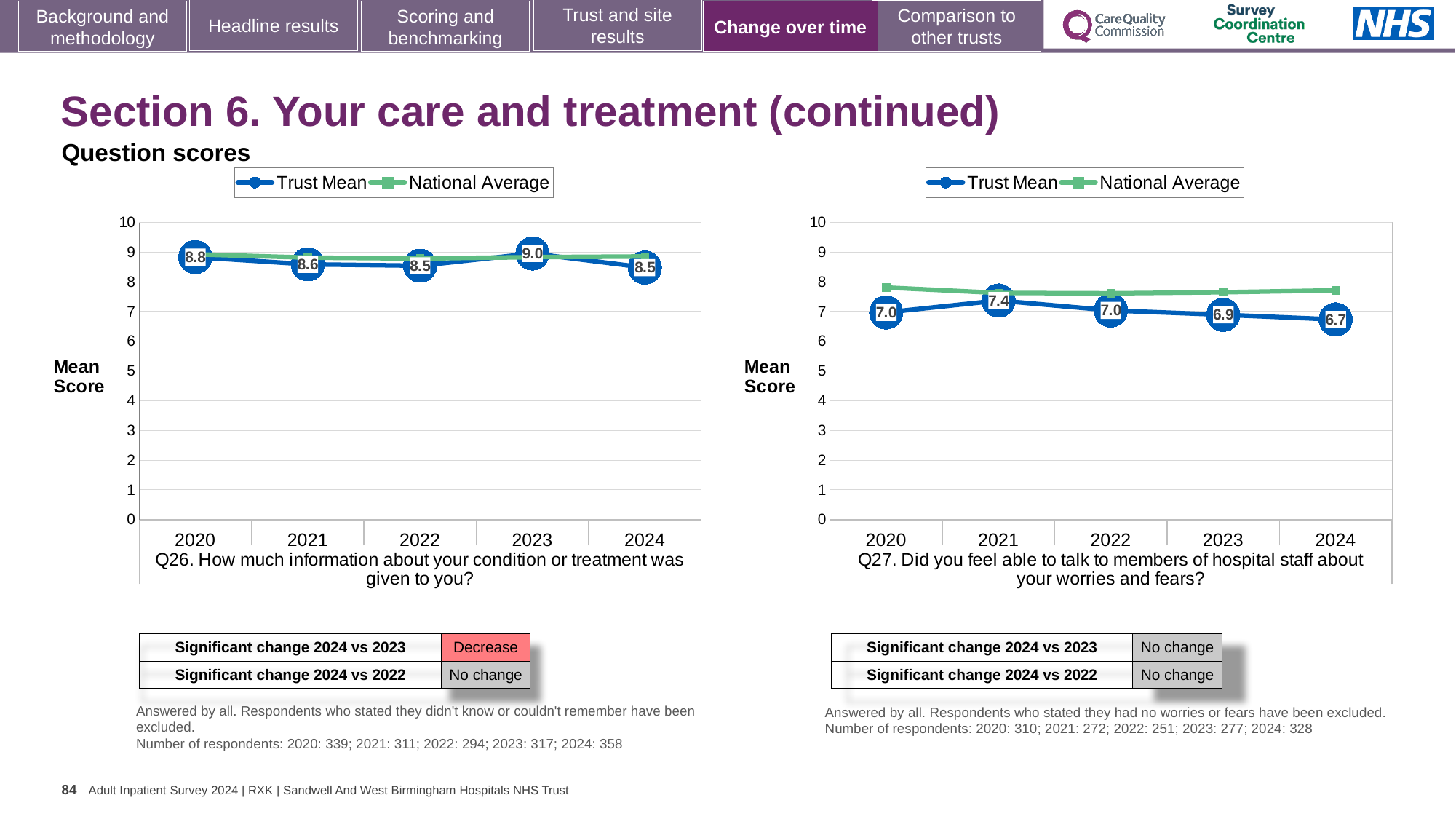
In the Q26 chart, what is the Trust Mean score for 2023? 9.0 In the Q27 chart, what is the Trust Mean score for 2024? 6.7 In the Q27 chart, what is the difference between the Trust Mean scores for 2021 and 2024? 0.7 In the Q27 chart, which year has the lowest Trust Mean score? 2024 In the Q26 chart, which year has the highest Trust Mean score? 2023 In the Q26 chart, what is the difference between the Trust Mean scores for 2023 and 2024? 0.5 In the Q27 chart, is the National Average for 2020 greater or less than 7? greater How many years are plotted on the x axis of the Q26 chart? 5 In the Q27 chart, is the Trust Mean score higher in 2020 or in 2021? 2021 How many series does the legend of the Q27 chart list? 2 In the Q27 chart, which year has the highest Trust Mean score? 2021 What kind of chart is used for Q27? Line chart